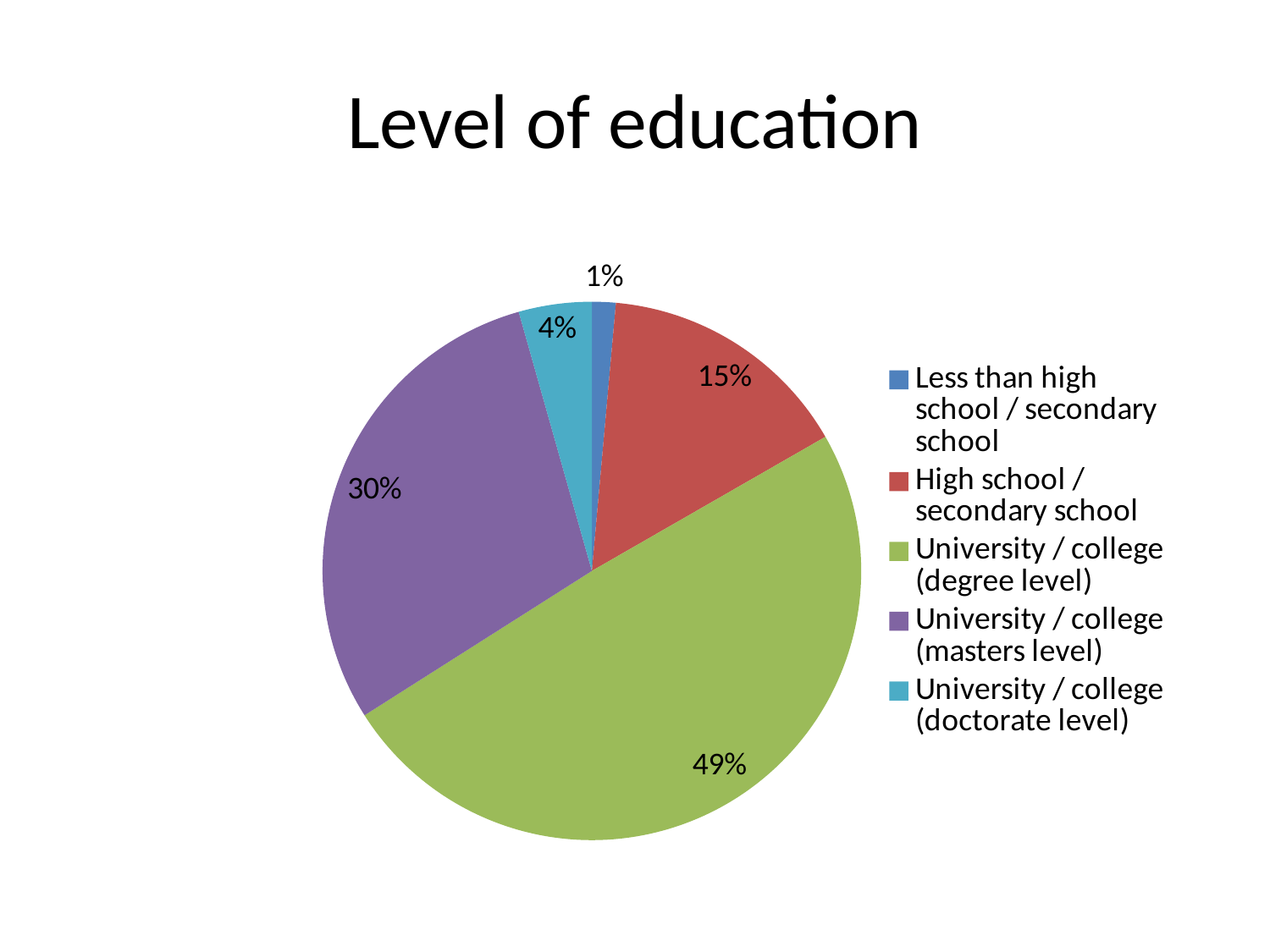
What is the difference in percentage points between University / college (degree level) and University / college (masters level)? 19 Which is larger: the share for High school / secondary school or the share for University / college (doctorate level)? High school / secondary school Which category has the largest slice of the pie? University / college (degree level) What share of the pie is University / college (masters level)? 30% What share of the pie is University / college (degree level)? 49% What share of the pie is University / college (doctorate level)? 4% What is the title of the chart? Level of education What kind of chart is shown on the slide? Pie chart How many categories does the pie chart show? 5 Which category has the smallest slice of the pie? Less than high school / secondary school